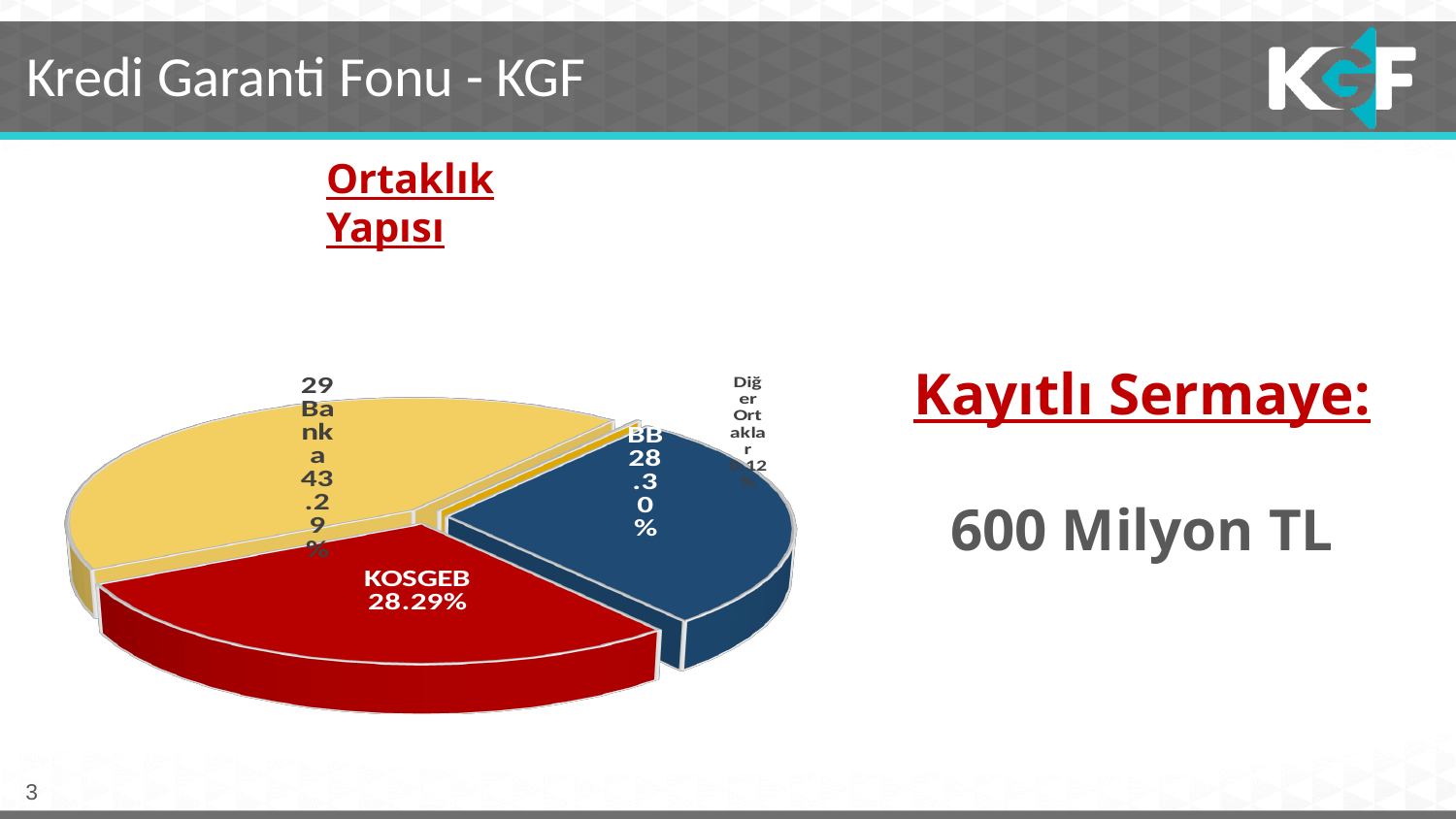
What share of the pie does KOSGEB hold? 28.29% Which slice of the pie chart is the smallest? Diğer Ortaklar What percentage is printed on the blue slice of the pie chart? 28.30% Which slice of the pie chart is the largest? 29 Banka What share of the pie is labelled for '29 Banka'? 43.29% What kind of chart is shown under the heading 'Ortaklık Yapısı'? pie chart Which is larger in the pie chart: the share of KOSGEB or the share of 29 Banka? 29 Banka By how many percentage points does the 29 Banka share exceed the KOSGEB share? 15.00 percentage points What is the title shown above the pie chart? Ortaklık Yapısı What colour is the KOSGEB slice in the pie chart? red How many slices does the pie chart have? 4